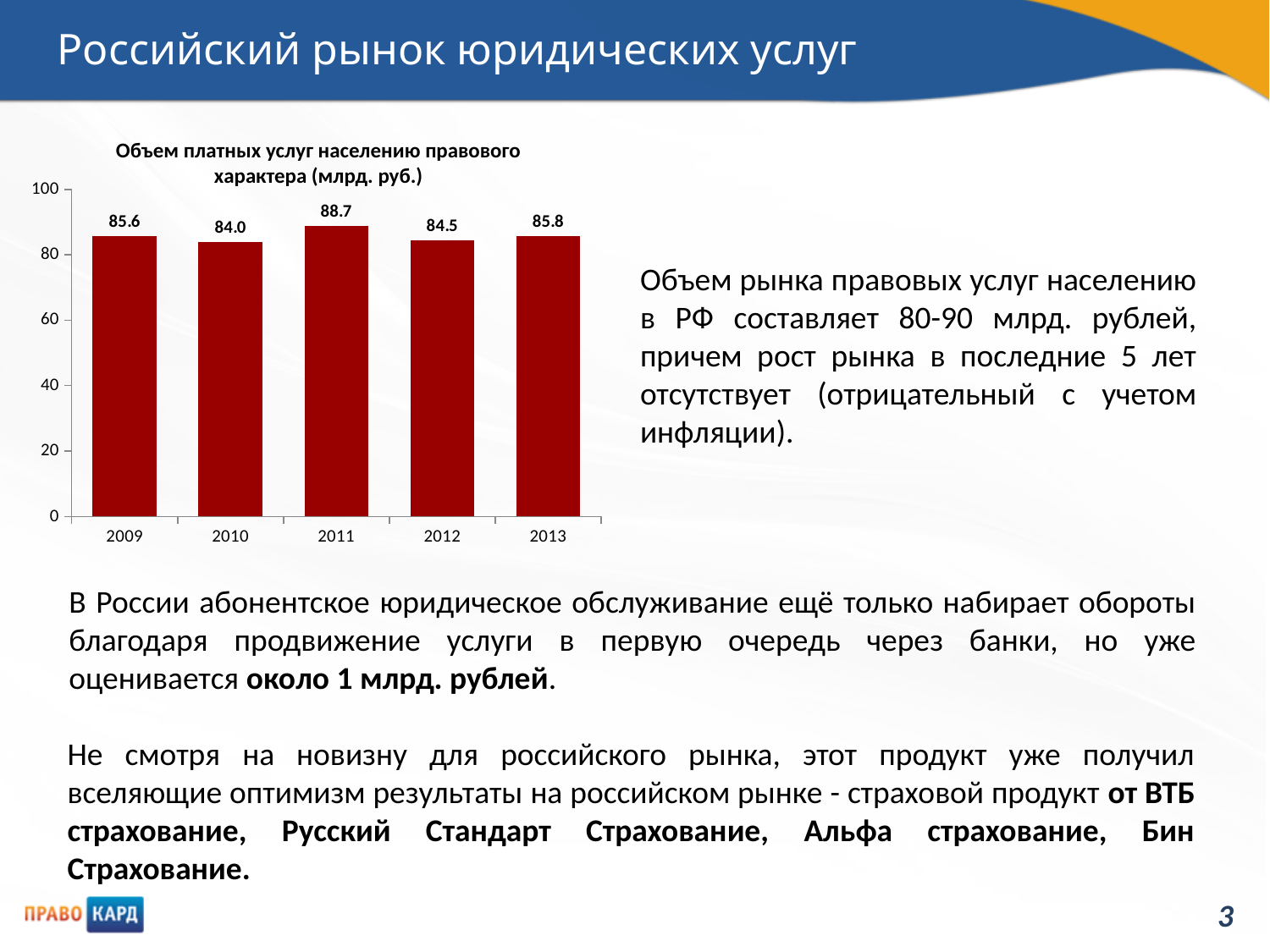
Which year has the lowest value? 2010 What is the title of the chart? Объем платных услуг населению правового характера (млрд. руб.) What is the value for 2009? 85.6 What kind of chart is shown on the slide? bar chart What is the value for 2011? 88.7 How many years are shown on the x axis? 5 What colour are the bars in the chart? dark red Which year has the highest value? 2011 Which is larger, the value for 2012 or the value for 2011? 2011 What is the difference between the values for 2011 and 2010? 4.7 What is the value for 2013? 85.8 Is the value for 2010 greater or less than 80? greater